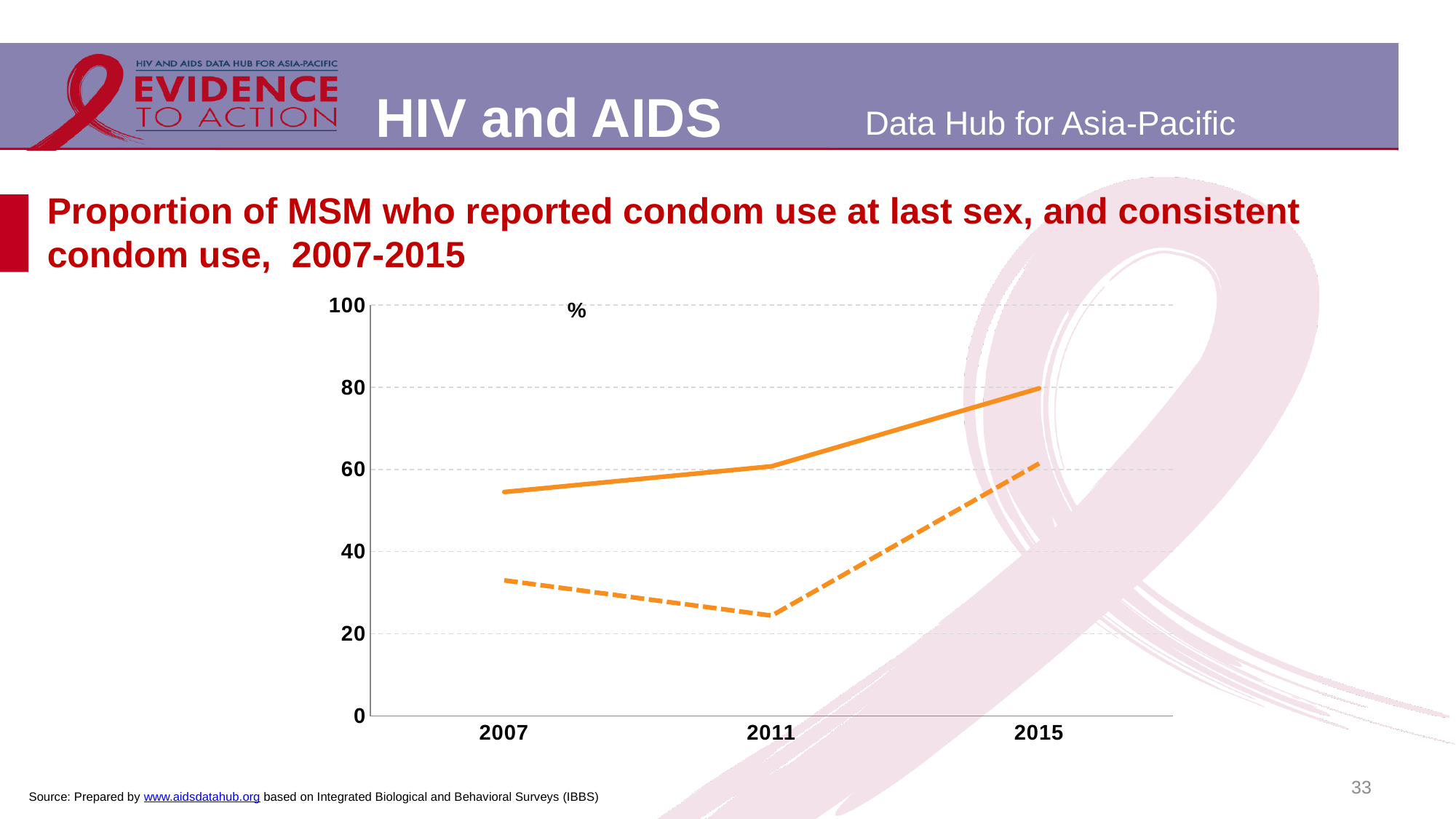
In which year does the solid line reach its highest value? 2015 In 2007, which line has the higher value, the solid line or the dashed line? solid line Is the value of the solid line in 2007 greater or less than 40? greater What kind of chart is shown on the slide? line chart How many years are shown on the x axis of the chart? 3 Is the value of the dashed line in 2011 greater or less than 20? greater Is the value of the dashed line in 2015 greater or less than 40? greater What unit is indicated at the top of the chart's y axis? % In which year does the dashed line reach its lowest value? 2011 Which years are shown on the x axis of the chart? 2007, 2011, 2015